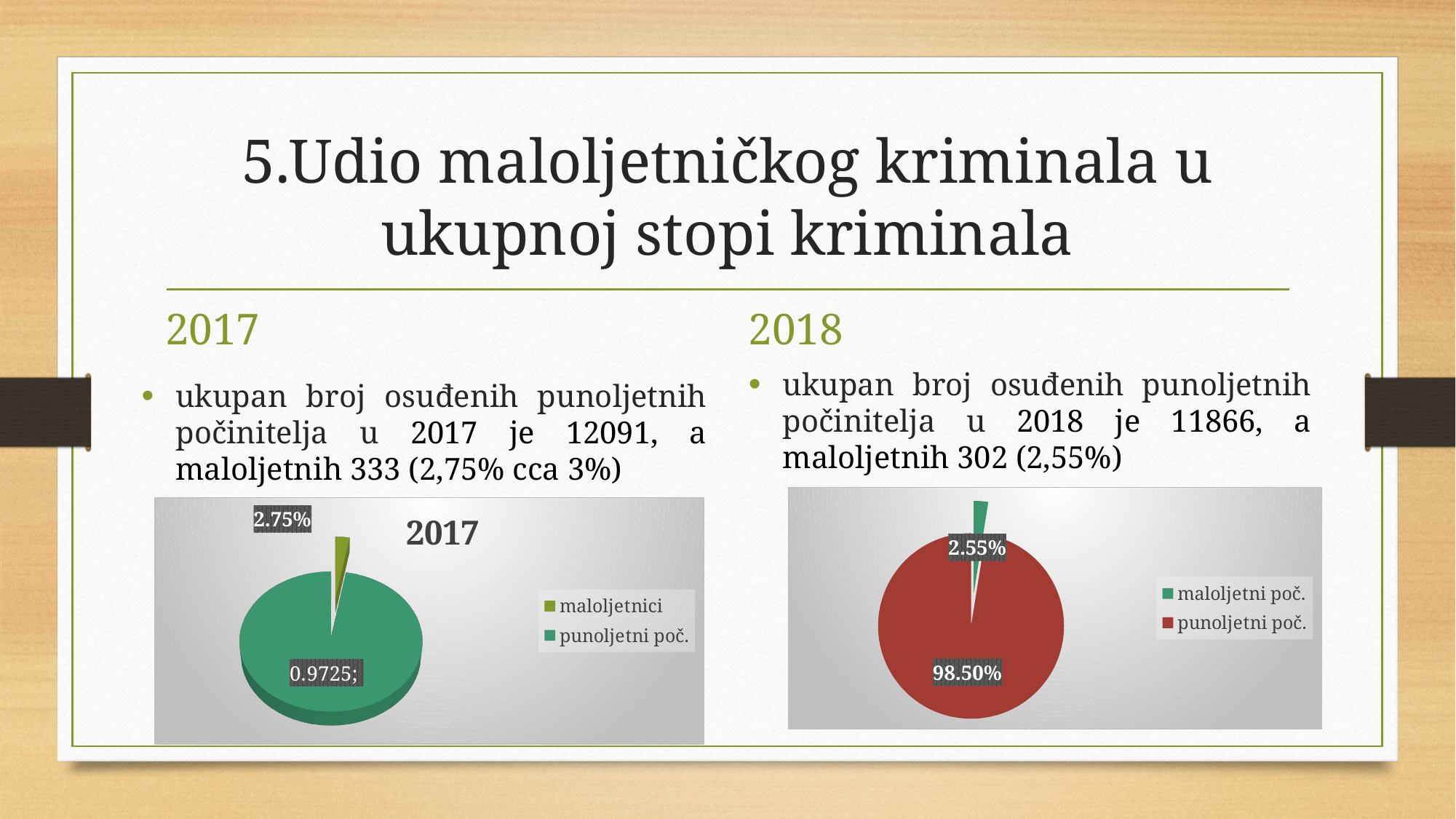
In the right pie chart (under the 2018 heading), what is the data label for the punoljetni poč. slice? 98.50% How many slices does the right pie chart (under the 2018 heading) have? 2 In the right pie chart (under the 2018 heading), what colour is the punoljetni poč. slice? red In the right pie chart (under the 2018 heading), what is the data label for the maloljetni poč. slice? 2.55% What type of chart is the left chart titled 2017? pie chart What is the title shown inside the left pie chart? 2017 In the right pie chart (under the 2018 heading), which slice is larger: maloljetni poč. or punoljetni poč.? punoljetni poč. In the left pie chart titled 2017, what is the data label shown for the maloljetnici slice? 2.75% How many entries does the legend of the left pie chart titled 2017 list? 2 In the left pie chart titled 2017, which slice is the smallest? maloljetnici In the right pie chart (under the 2018 heading), which slice is the largest? punoljetni poč. In the left pie chart titled 2017, what is the data label shown for the punoljetni poč. slice? 0.9725;